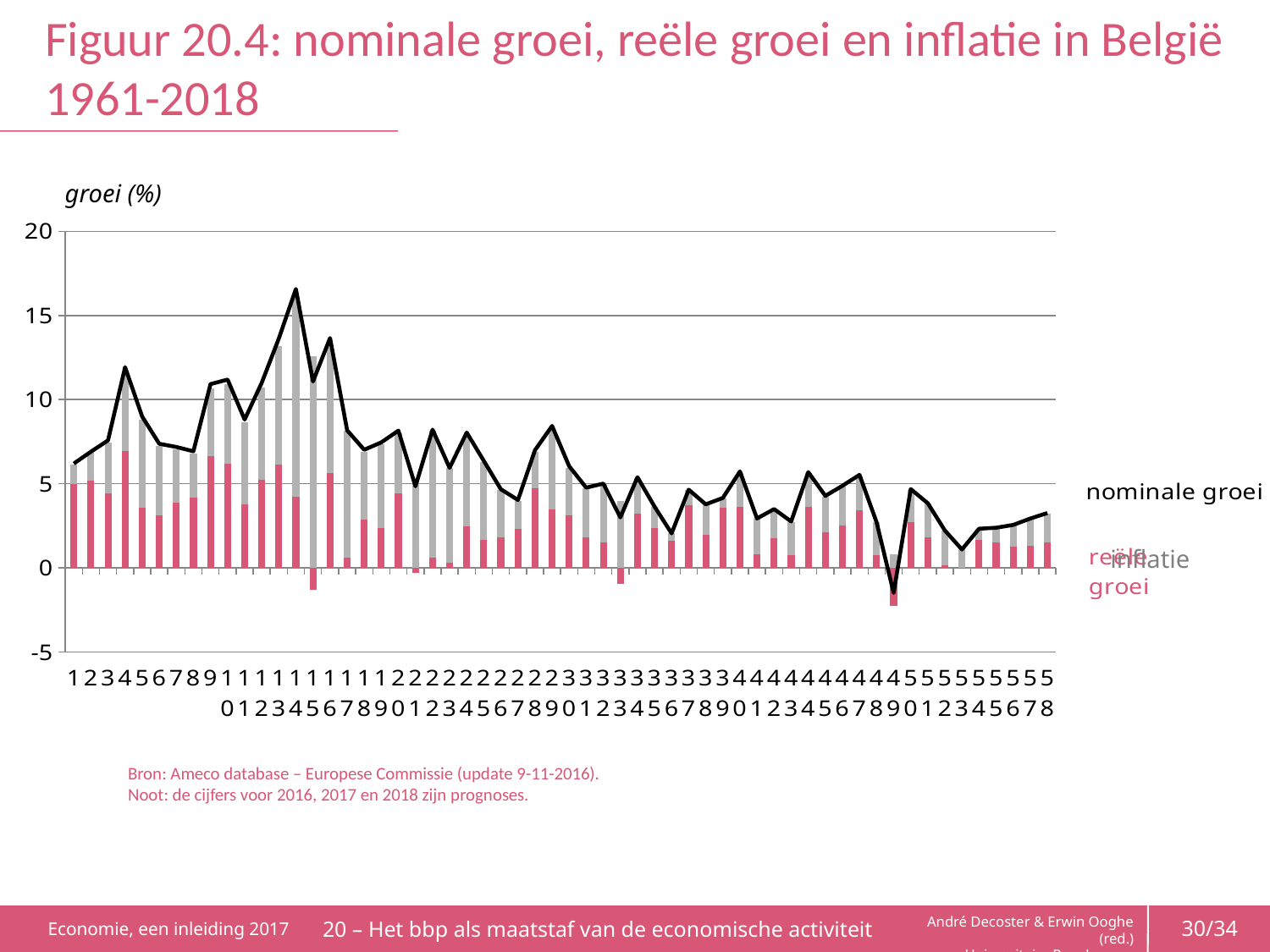
Is the value of nominale groei for the last category (58) greater or less than 5? less Is the value of nominale groei for the first category (1) greater or less than 5? greater Which series is drawn as a line rather than as bars? nominale groei What is the title of the chart on the slide? Figuur 20.4: nominale groei, reële groei en inflatie in België 1961-2018 What kind of chart is shown on the slide? A stacked bar chart combined with a line Is the highest value of the nominale groei line greater or less than 15? greater How many series does the chart's legend list? 3 Is the nominale groei value for category 15 larger or smaller than the value for category 50? larger Over the whole period, does the nominale groei line generally rise or fall from left to right? fall Which series reaches the highest value on the chart? nominale groei How many categories are plotted along the x axis? 58